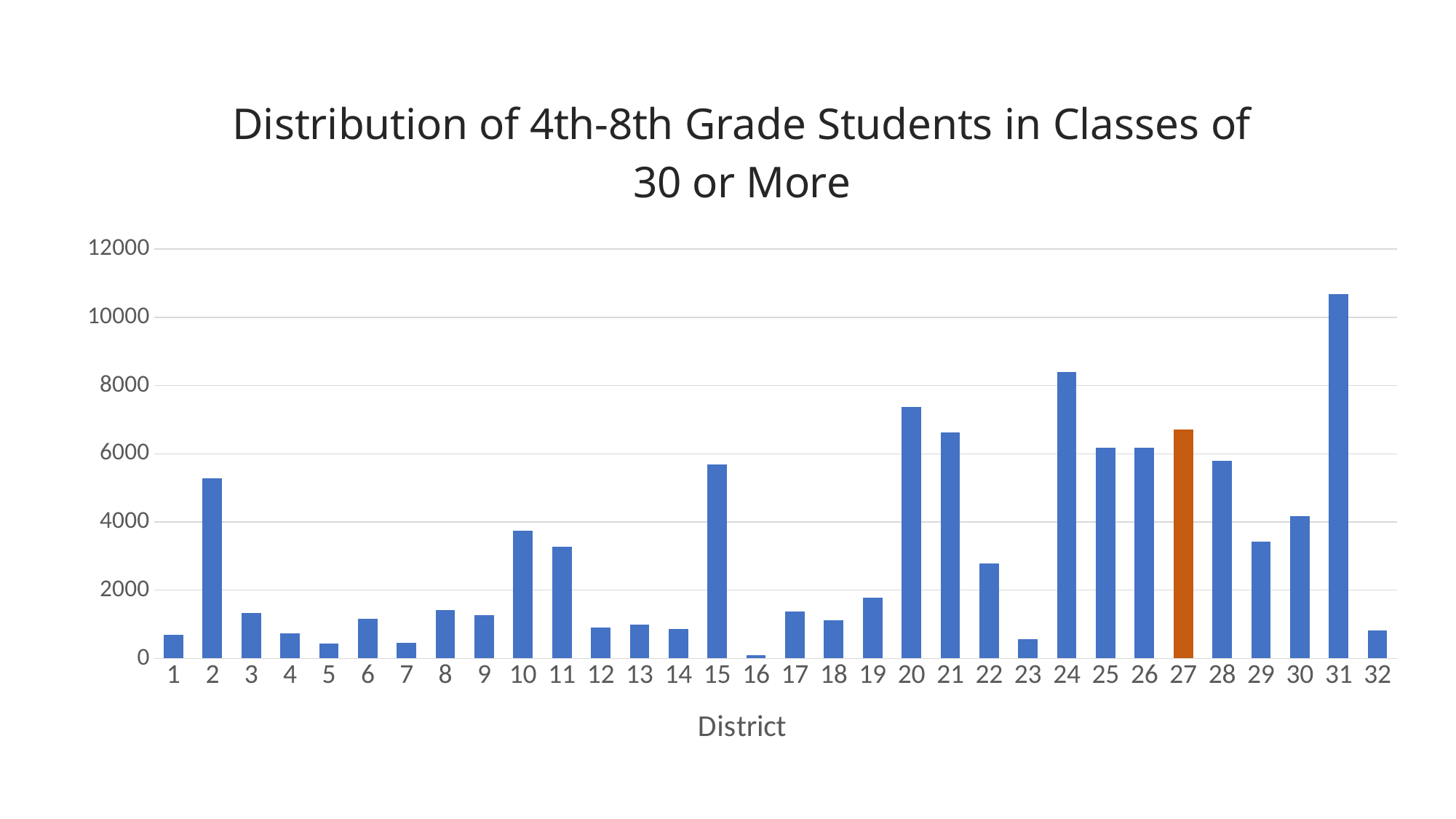
How many districts are shown on the x axis of the chart? 32 Which district has the larger value, district 2 or district 3? 2 What kind of chart is shown on the slide? bar chart Which district's bar is highlighted in orange rather than blue? 27 Which district has the highest number of students in classes of 30 or more? 31 Which district has the larger value, district 24 or district 20? 24 Is the value for district 2 greater or less than 4000? greater Is the value for district 16 greater or less than 2000? less Is the value for district 20 greater or less than 8000? less Which district has the lowest number of students in classes of 30 or more? 16 What is the title of the chart? Distribution of 4th-8th Grade Students in Classes of 30 or More